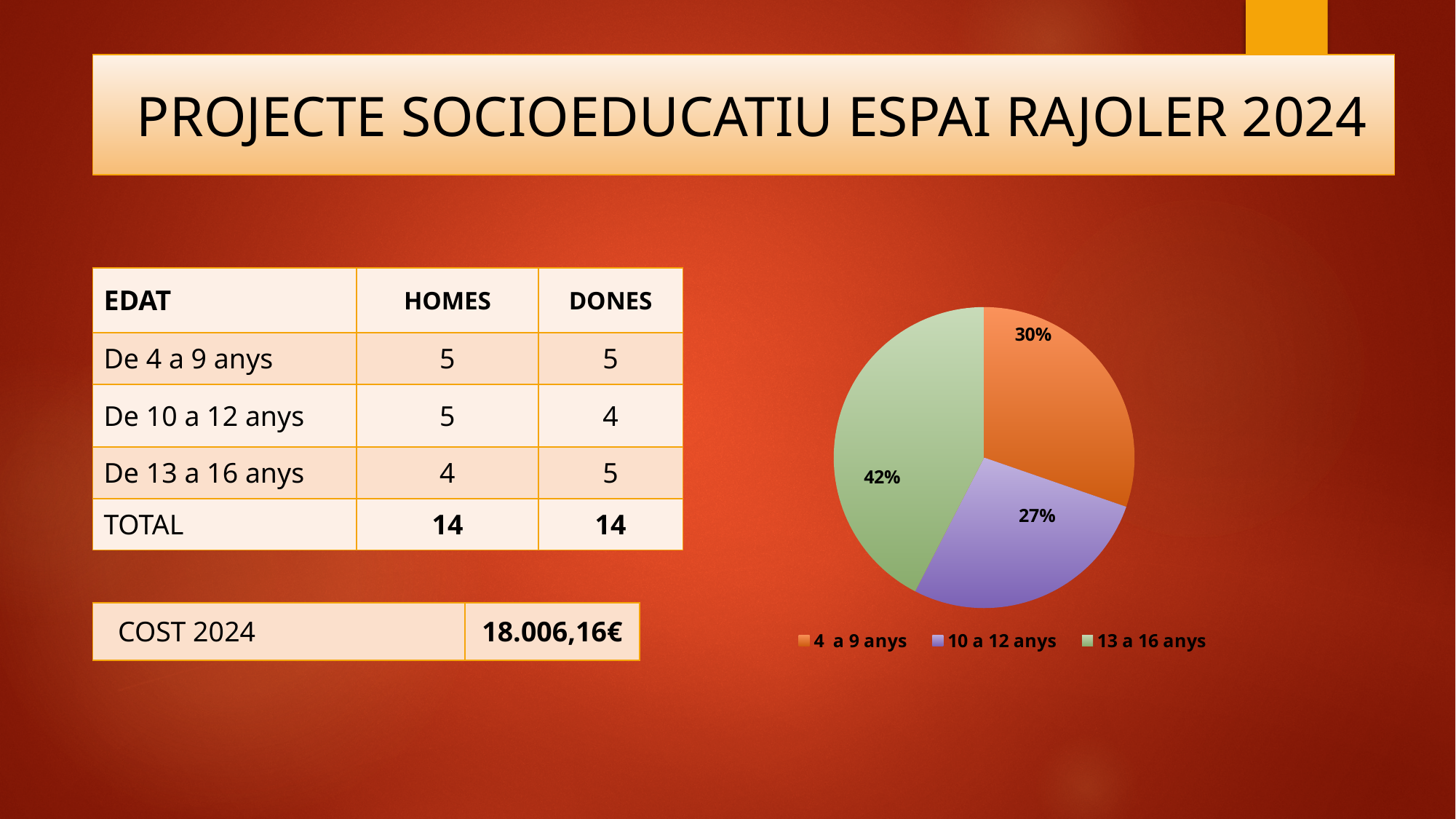
What is the difference in percentage points between the "13 a 16 anys" slice and the "4 a 9 anys" slice? 12 What share of the pie does the "4 a 9 anys" slice represent? 30% What share of the pie does the "13 a 16 anys" slice represent? 42% Which slice is larger, "4 a 9 anys" or "10 a 12 anys"? 4 a 9 anys How many entries does the pie chart's legend list? 3 What colour is the "13 a 16 anys" slice in the pie chart? green What share of the pie does the "10 a 12 anys" slice represent? 27% Which age group has the largest slice of the pie? 13 a 16 anys Which age group has the smallest slice of the pie? 10 a 12 anys What colour is the "10 a 12 anys" slice in the pie chart? purple How many slices does the pie chart have? 3 What kind of chart is shown on the slide? pie chart